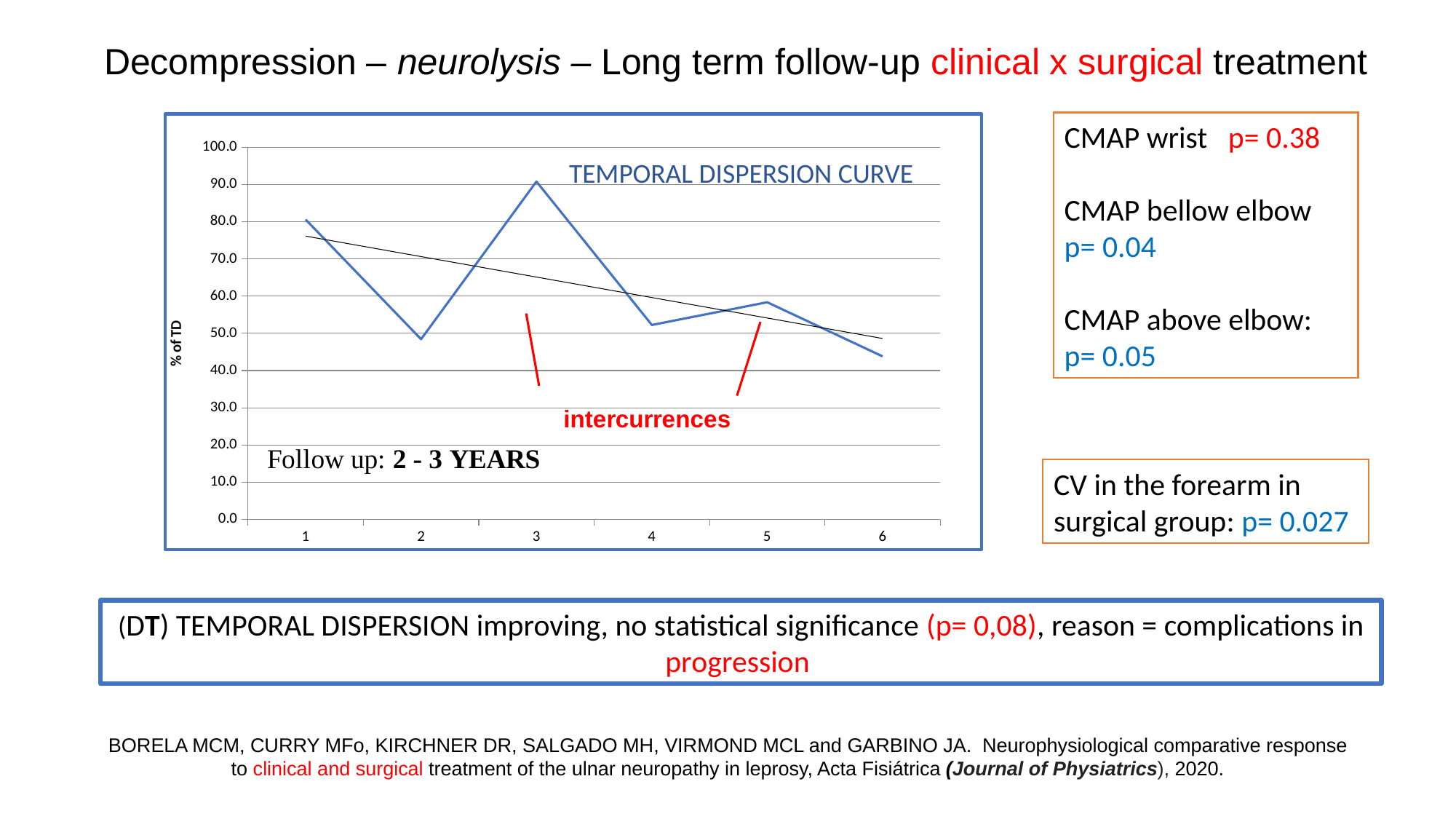
What kind of chart is shown on the slide? line chart What is the title printed inside the chart area? TEMPORAL DISPERSION CURVE Is the value of the temporal dispersion curve at point 2 greater or less than 60.0? less Is the value of the temporal dispersion curve at point 3 greater or less than 80.0? greater Which has the higher value on the temporal dispersion curve, point 4 or point 5? point 5 Which has the higher value on the temporal dispersion curve, point 1 or point 2? point 1 How many points are plotted along the x axis of the temporal dispersion curve? 6 What is the label on the y axis of the chart? % of TD Does the straight trend line drawn on the chart rise or fall from point 1 to point 6? fall At which x-axis point does the temporal dispersion curve reach its highest value? 3 Is the value of the temporal dispersion curve at point 1 greater or less than 70.0? greater